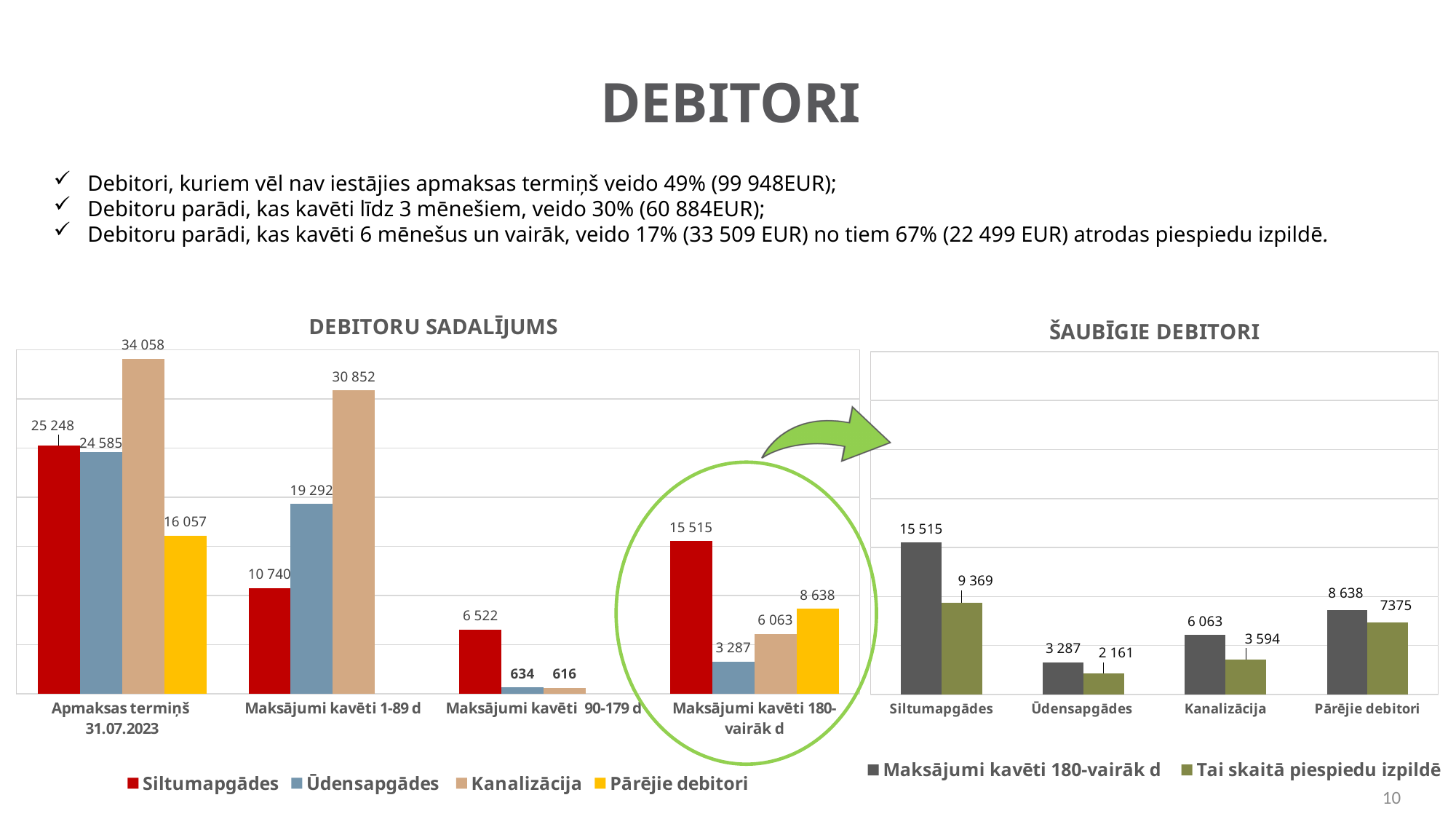
In the DEBITORU SADALĪJUMS chart, how many series does the legend list? 4 What kind of chart is the DEBITORU SADALĪJUMS chart? Bar chart In the ŠAUBĪGIE DEBITORI chart, how many categories are shown on the x axis? 4 In the ŠAUBĪGIE DEBITORI chart, what is the value of Tai skaitā piespiedu izpildē for Kanalizācija? 3 594 In the DEBITORU SADALĪJUMS chart, what is the value for Ūdensapgādes in the Maksājumi kavēti 1-89 d category? 19 292 In the ŠAUBĪGIE DEBITORI chart, which category has the highest value for Maksājumi kavēti 180-vairāk d? Siltumapgādes In the DEBITORU SADALĪJUMS chart, which series has the lowest value in the Maksājumi kavēti 90-179 d category? Kanalizācija In the DEBITORU SADALĪJUMS chart, which series has the highest value in the Maksājumi kavēti 180-vairāk d category? Siltumapgādes In the DEBITORU SADALĪJUMS chart, what is the difference between Siltumapgādes and Ūdensapgādes in the Apmaksas termiņš 31.07.2023 category? 663 In the ŠAUBĪGIE DEBITORI chart, what is the difference between Maksājumi kavēti 180-vairāk d and Tai skaitā piespiedu izpildē for Siltumapgādes? 6 146 In the DEBITORU SADALĪJUMS chart, what is the value for Kanalizācija in the Apmaksas termiņš 31.07.2023 category? 34 058 In the ŠAUBĪGIE DEBITORI chart, which is larger for Ūdensapgādes: Maksājumi kavēti 180-vairāk d or Tai skaitā piespiedu izpildē? Maksājumi kavēti 180-vairāk d